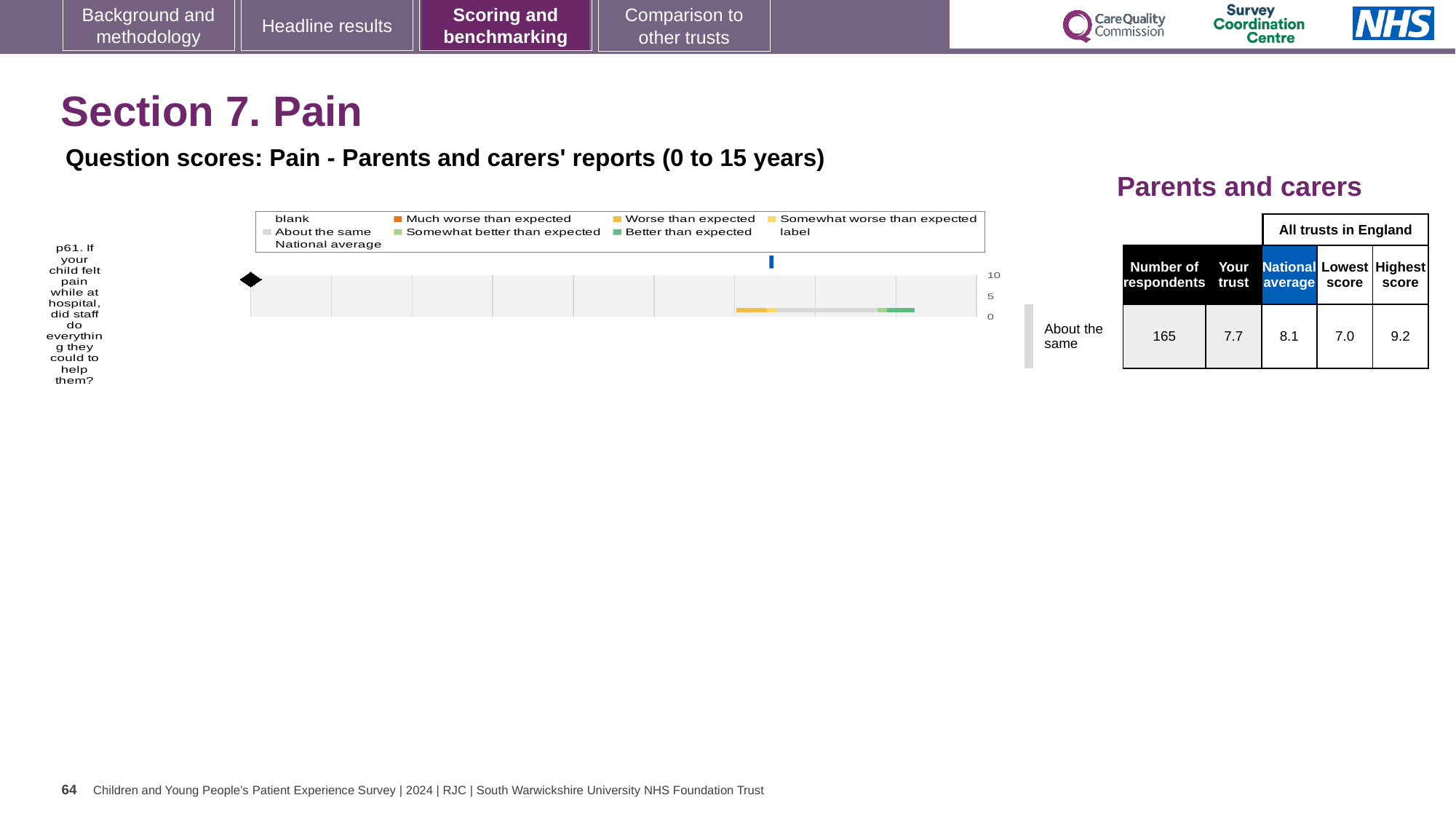
What kind of chart is shown on the slide for question p61? bar chart In the table next to the chart, what is the national average score for question p61? 8.1 In the table next to the chart, what is the 'Your trust' score for question p61? 7.7 Which question number is plotted in the chart? p61 In the table next to the chart, how many respondents answered question p61? 165 For question p61, which is larger: the 'Your trust' score or the national average? National average What colour does the chart legend use for 'Better than expected'? green In the table next to the chart, what is the lowest score among all trusts in England for question p61? 7.0 For question p61, what is the difference between the highest score and the lowest score among all trusts in England? 2.2 How many survey questions are plotted in the chart on the slide? 1 In the table next to the chart, what is the highest score among all trusts in England for question p61? 9.2 How many entries does the chart legend list? 9